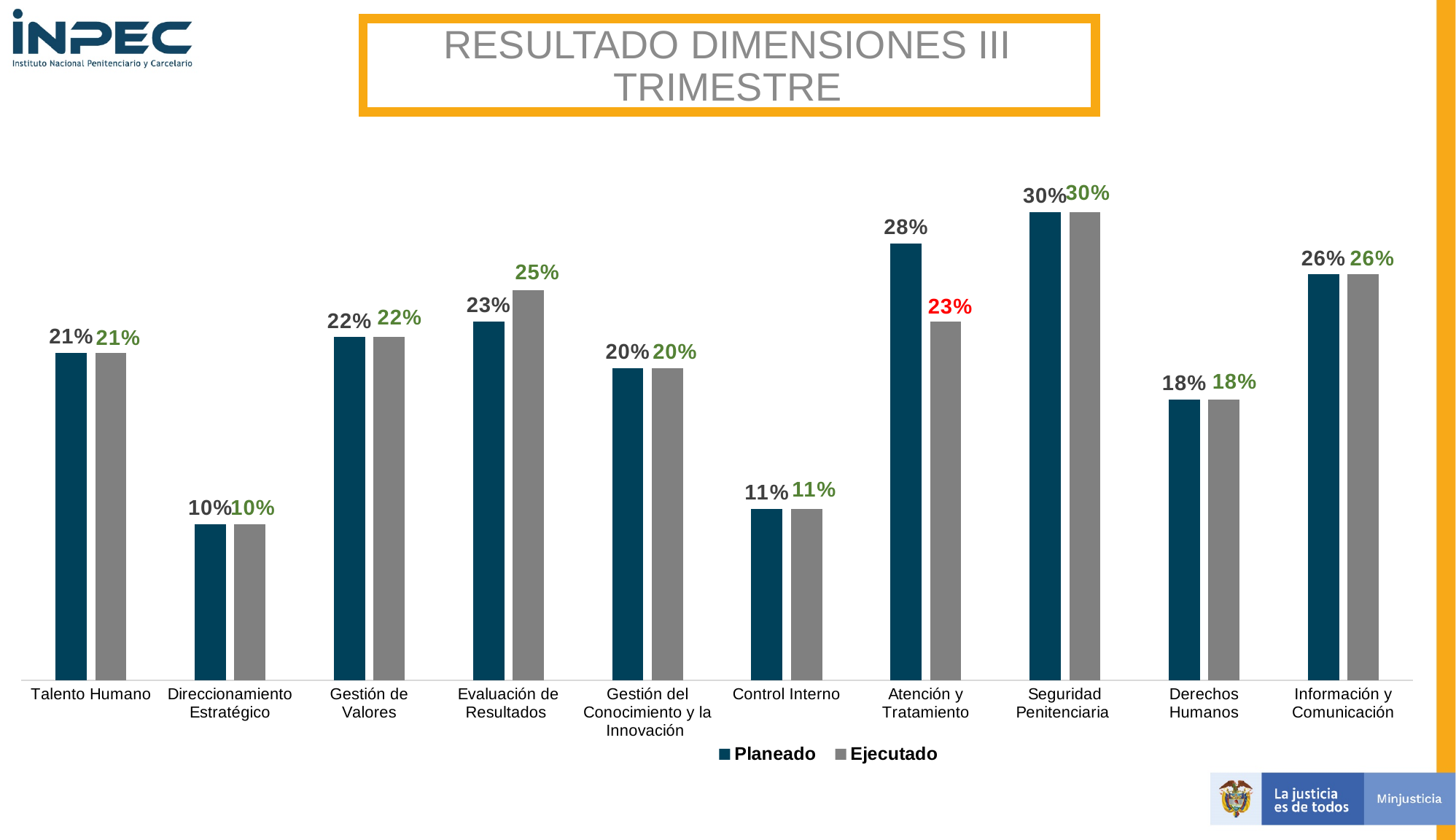
How many series does the legend list? 2 What kind of chart is shown on the slide? Bar chart Which category has the lowest Ejecutado value? Direccionamiento Estratégico What is the Planeado value for Atención y Tratamiento? 28% What is the Ejecutado value for Evaluación de Resultados? 25% Which category has the highest Planeado value? Seguridad Penitenciaria What is the difference between the Planeado and Ejecutado values for Atención y Tratamiento? 5% Which is larger for Evaluación de Resultados, the Planeado value or the Ejecutado value? Ejecutado How many categories are shown on the x axis? 10 What is the title of the slide? RESULTADO DIMENSIONES III TRIMESTRE Which series is shown in grey in the legend? Ejecutado What is the Ejecutado value for Atención y Tratamiento? 23%